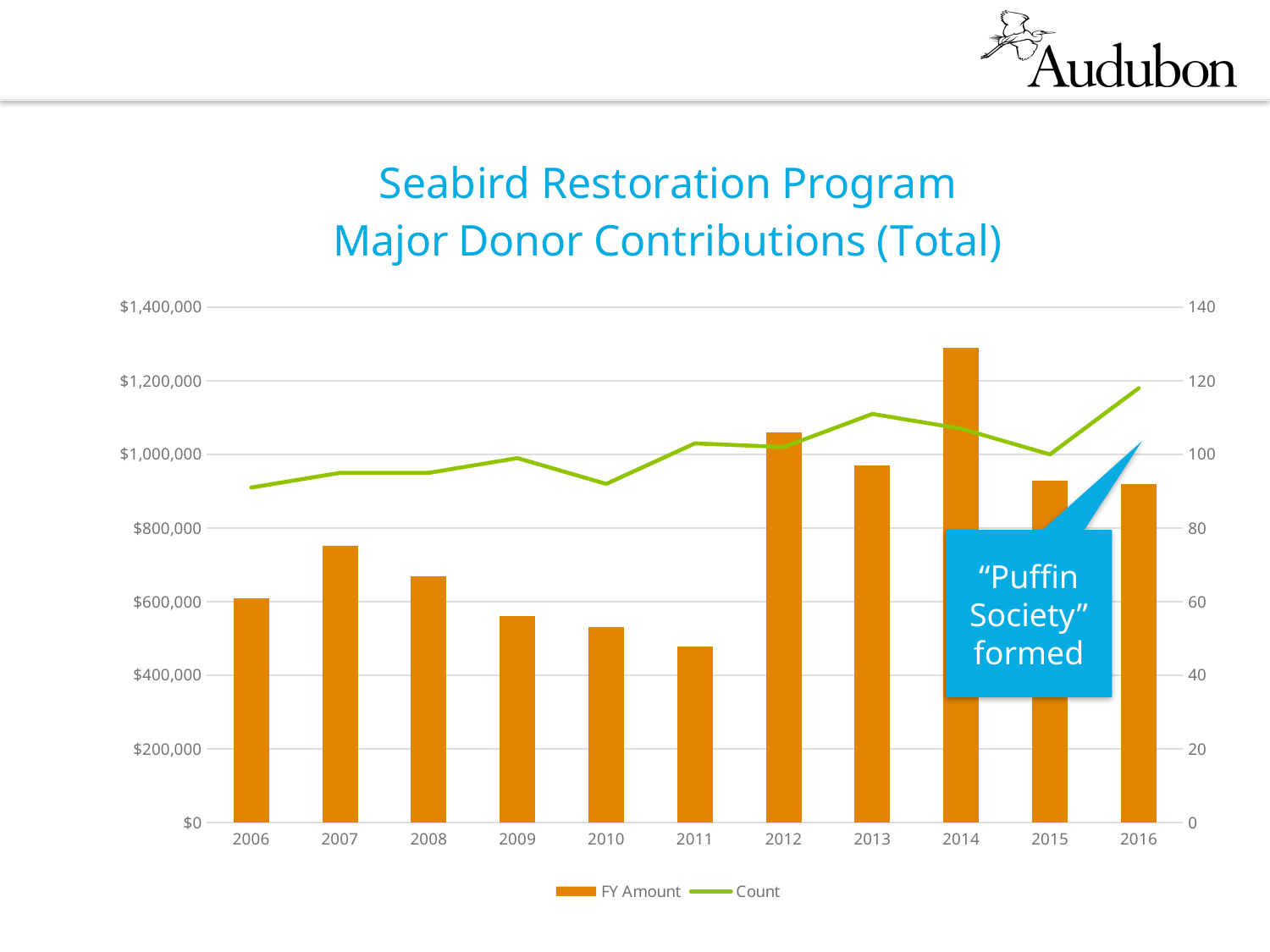
Does the FY Amount rise or fall from 2007 to 2011? fall Is the Count for 2016 greater or less than 100? greater Is the FY Amount for 2011 greater or less than $600,000? less How many years are shown on the x axis? 11 Which year has the highest Count? 2016 How many series does the legend list? 2 Which year has the lowest FY Amount? 2011 Which year has the highest FY Amount? 2014 What text appears in the blue callout on the chart? "Puffin Society" formed Is the FY Amount for 2014 greater or less than $1,200,000? greater What type of chart is used to show the FY Amount series? bar chart Which year has the larger FY Amount, 2007 or 2008? 2007